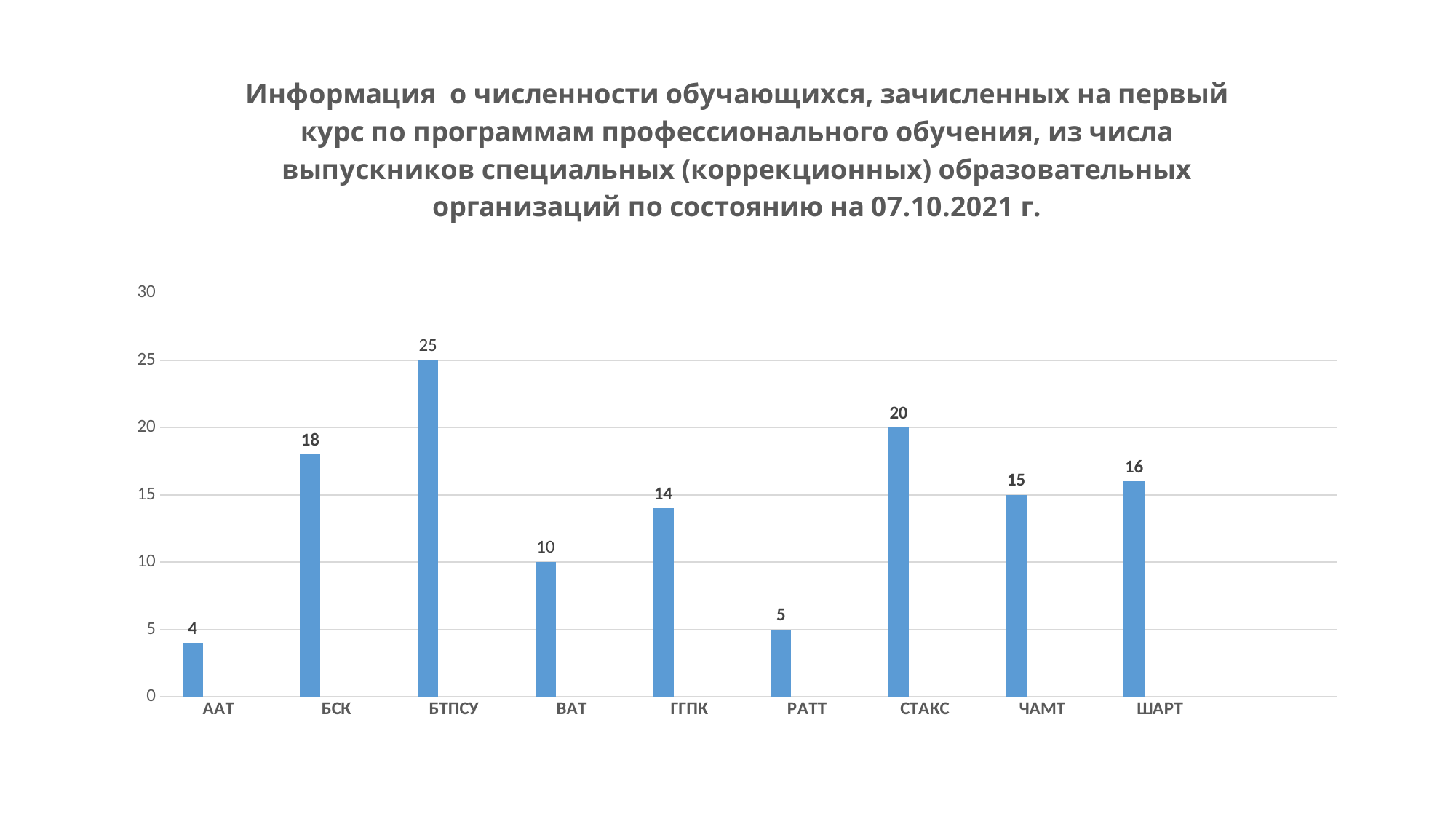
Which is larger, the value for ЧАМТ or the value for ШАРТ? ШАРТ Which category has the lowest value? ААТ Is the value for ГГПК greater or less than 10? greater What is the value for ААТ? 4 What is the value for БТПСУ? 25 What is the difference between the values for БТПСУ and СТАКС? 5 How many categories are shown on the x axis? 9 What kind of chart is shown on the slide? bar chart What is the value for РАТТ? 5 What is the difference between the values for БСК and ВАТ? 8 Which category has the highest value? БТПСУ What is the value for СТАКС? 20